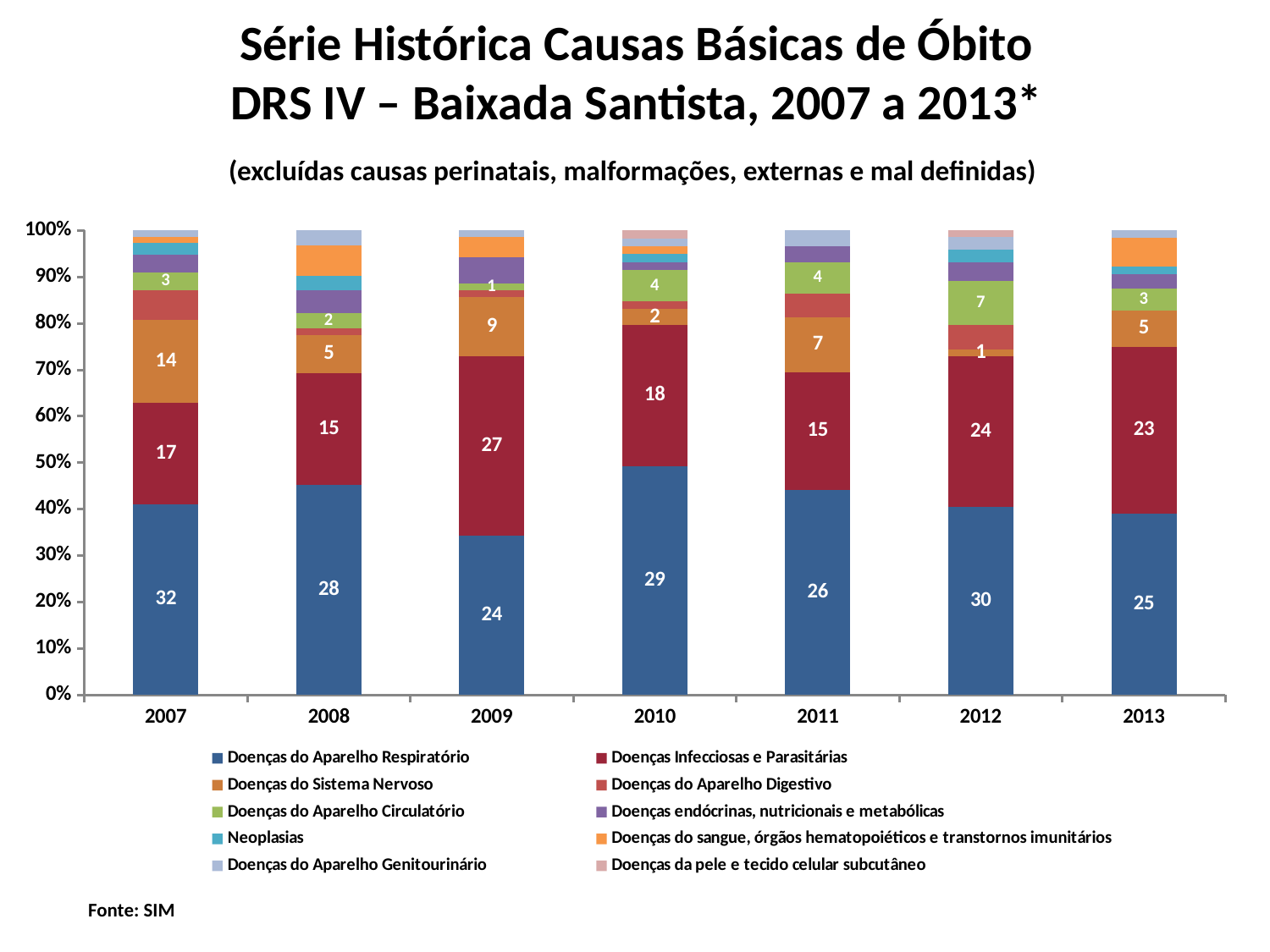
Which year has the highest data label for Doenças do Aparelho Respiratório? 2007 What is the difference between the Doenças Infecciosas e Parasitárias labels for 2012 and 2011? 9 How many series does the legend list? 10 What is the data label for Doenças do Sistema Nervoso in 2011? 7 Which is larger in 2013: the label for Doenças do Aparelho Respiratório or for Doenças Infecciosas e Parasitárias? Doenças do Aparelho Respiratório What is the data label for Doenças do Aparelho Circulatório in 2012? 7 What is the data label for Doenças Infecciosas e Parasitárias in 2009? 27 What is the source cited below the chart? SIM What is the data label for Doenças do Aparelho Respiratório in 2007? 32 Which year has the lowest data label for Doenças do Aparelho Respiratório? 2009 What type of chart is shown on the slide? stacked bar chart How many years are shown on the x axis? 7